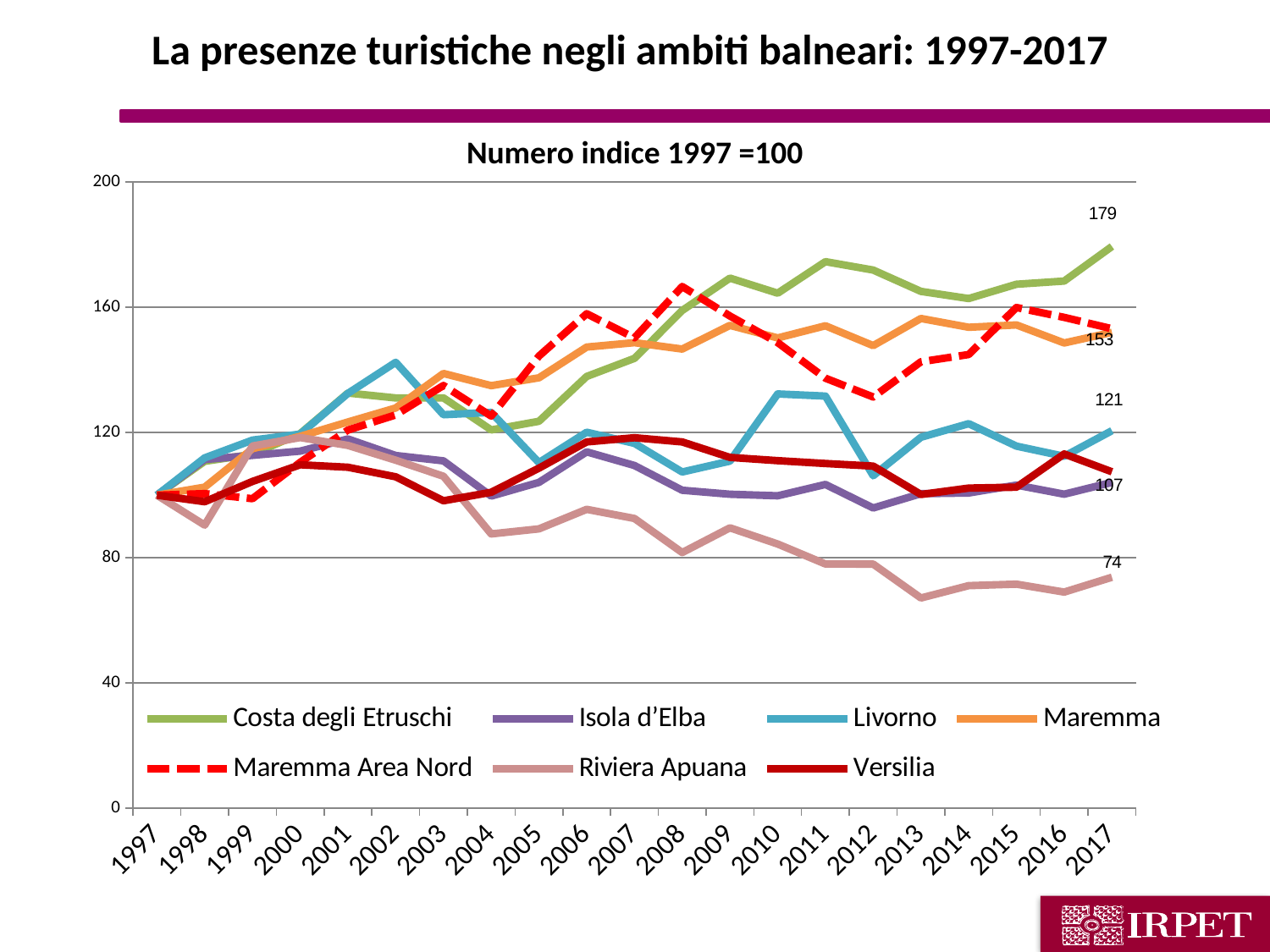
What is the difference between the 2017 values of Costa degli Etruschi and Riviera Apuana? 105 Which series has the highest value in 2017? Costa degli Etruschi What kind of chart is shown on the slide? line chart What is the index value for Riviera Apuana in 2017? 74 Does the Riviera Apuana series rise or fall overall from 1997 to 2017? fall How many years are plotted along the x axis? 21 Which series is drawn with a dashed line? Maremma Area Nord What is the index value for Livorno in 2017? 121 Is the value for Riviera Apuana in 2013 greater or less than 80? less How many series does the legend list? 7 Which series has the lowest value in 2017? Riviera Apuana What is the index value for Costa degli Etruschi in 2017? 179